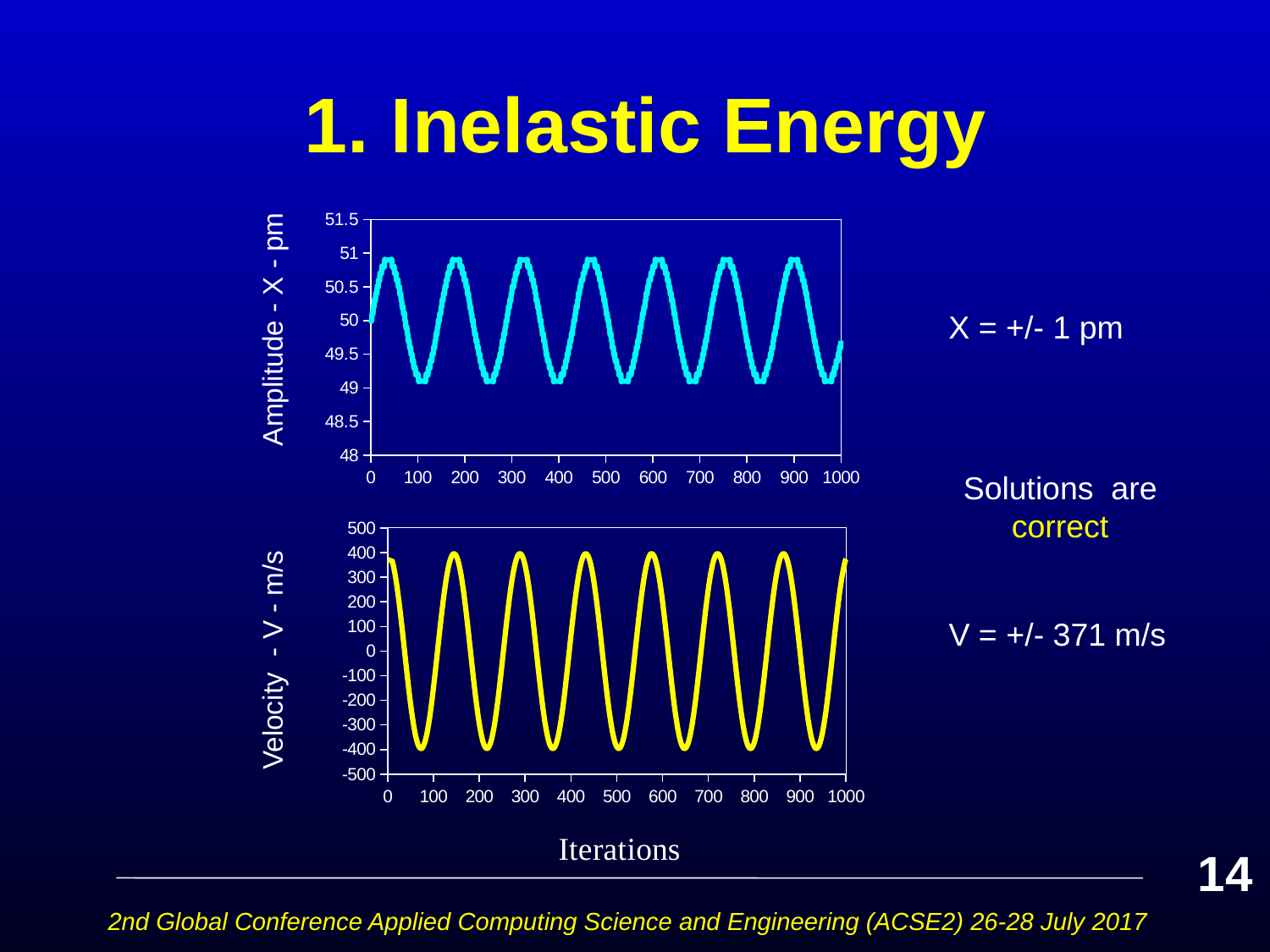
In the bottom chart, what is the label of the vertical axis? Velocity - V - m/s In the bottom chart, is the lowest velocity value greater or less than -300? less In the top chart, is the peak amplitude value greater or less than 50.5? greater In the bottom chart, is the velocity at iteration 0 greater or less than 0? greater In the top chart, what is the label of the vertical axis? Amplitude - X - pm In the top chart, does the amplitude rise steadily, fall steadily, or oscillate as the iterations increase? oscillate What kind of chart is the top chart on the slide? line chart In the bottom chart, does the velocity rise steadily, fall steadily, or oscillate as the iterations increase? oscillate What kind of chart is the bottom chart on the slide? line chart In the top chart, what is the amplitude value at iteration 0? 50